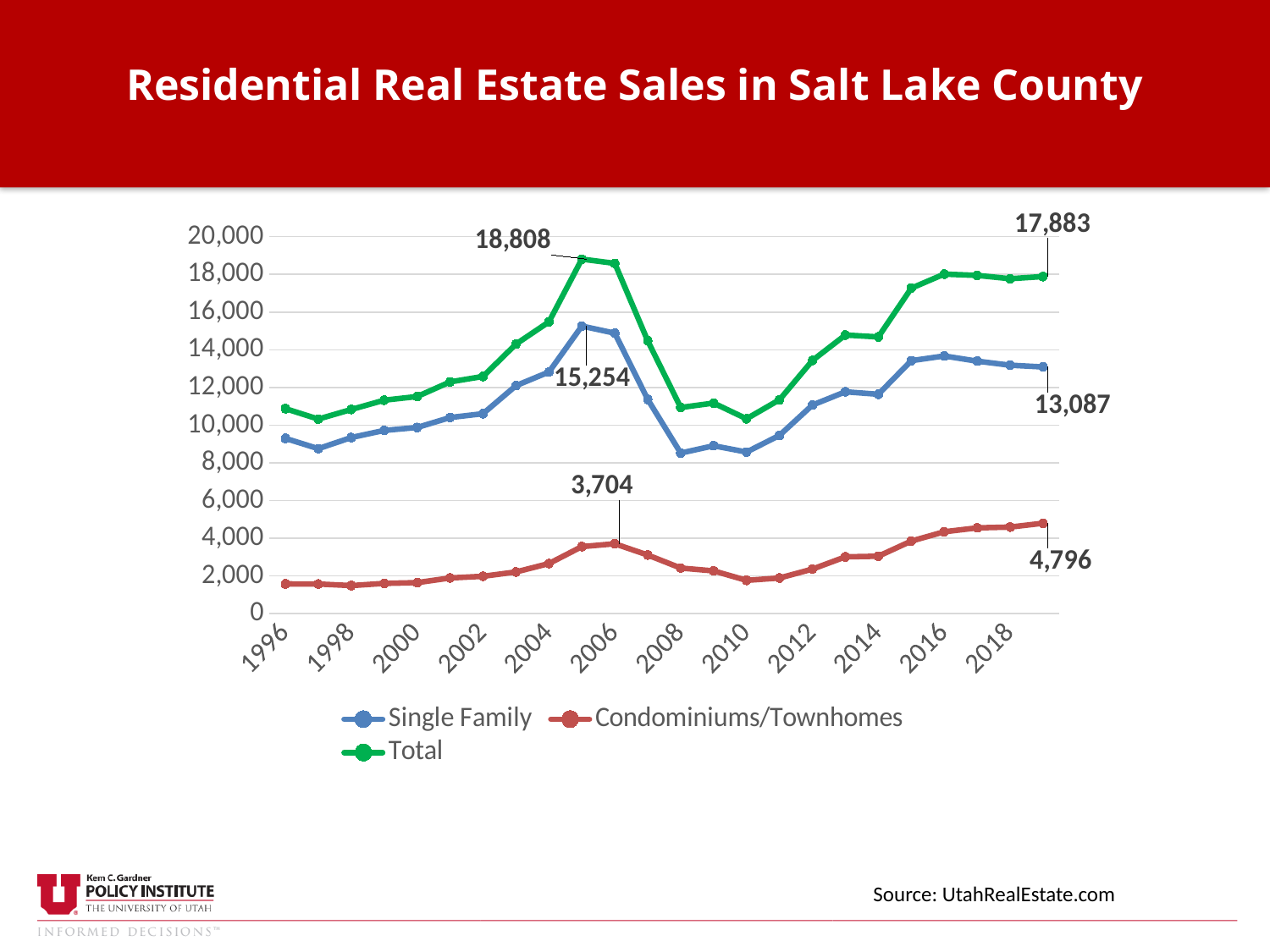
How many series does the legend list? 3 What is the peak value labelled on the Total series? 18,808 By how much is the labelled Total peak (18,808) higher than the labelled Single Family peak (15,254)? 3,554 What is the value labelled at the end of the Total series (the last year shown)? 17,883 What type of chart is shown on the slide? Line chart Is the Single Family value in 2010 greater or less than 10,000? less Is the Total value in 2016 greater or less than 16,000? greater What is the difference between the final labelled Total value (17,883) and the final labelled Single Family value (13,087)? 4,796 Which series has the highest values throughout the chart: Single Family, Condominiums/Townhomes, or Total? Total What is the peak value labelled on the Single Family series? 15,254 What is the peak value labelled on the Condominiums/Townhomes series? 3,704 What is the value labelled at the end of the Condominiums/Townhomes series (the last year shown)? 4,796